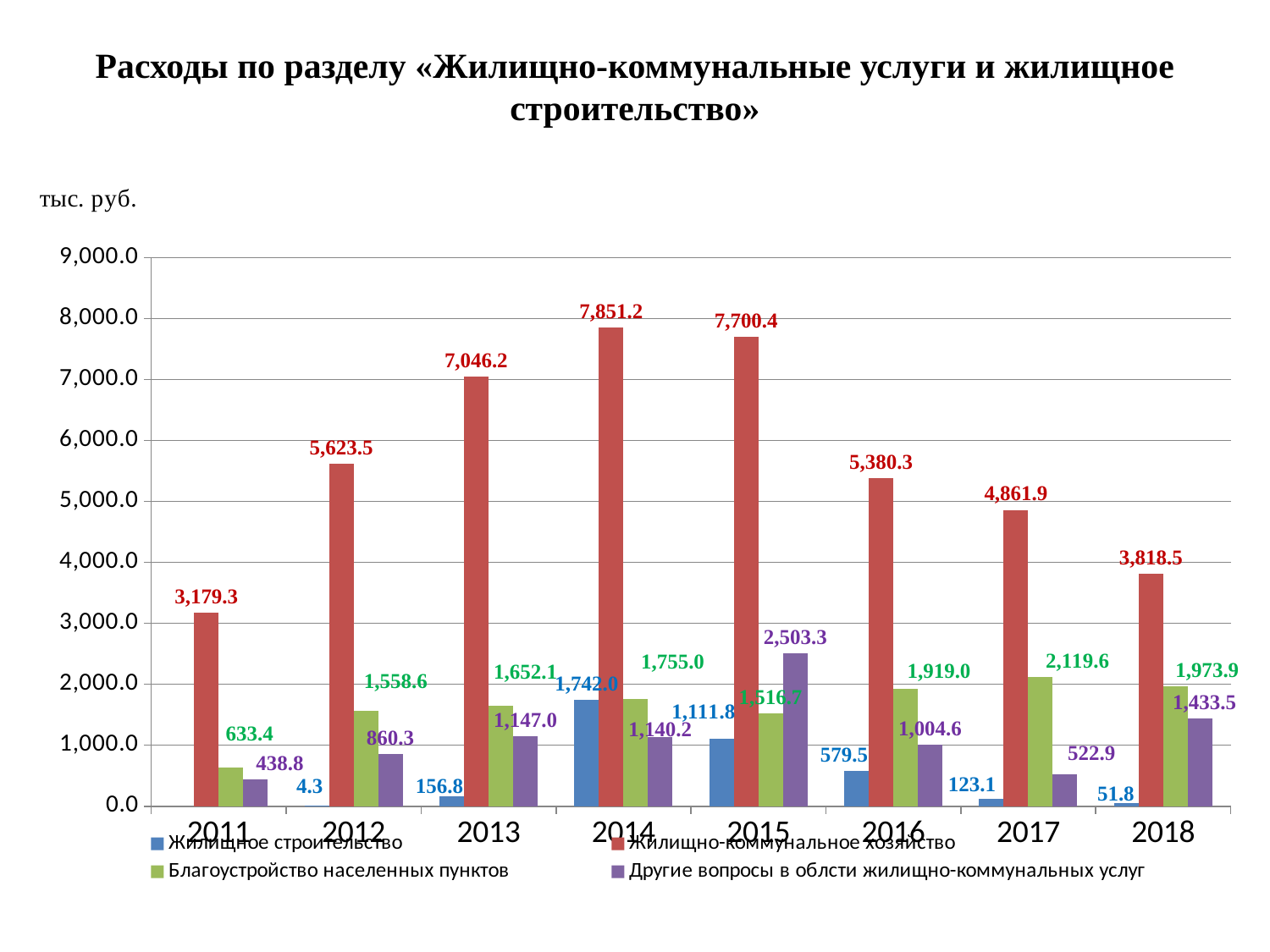
In which year is the value for Жилищно-коммунальное хозяйство the highest? 2014 What is the difference between the Жилищно-коммунальное хозяйство values in 2014 and 2018? 4,032.7 What is the value for Другие вопросы в области жилищно-коммунальных услуг in 2015? 2,503.3 Which is larger in 2015: Благоустройство населенных пунктов or Другие вопросы в области жилищно-коммунальных услуг? Другие вопросы в области жилищно-коммунальных услуг What unit is indicated for the values on the chart? тыс. руб. What is the value for Жилищное строительство in 2016? 579.5 What is the value for Жилищно-коммунальное хозяйство in 2014? 7,851.2 What type of chart is shown on the slide? bar chart How many years are shown on the x axis? 8 What is the value for Благоустройство населенных пунктов in 2017? 2,119.6 How many series does the legend list? 4 In which year is the value for Жилищно-коммунальное хозяйство the lowest? 2011